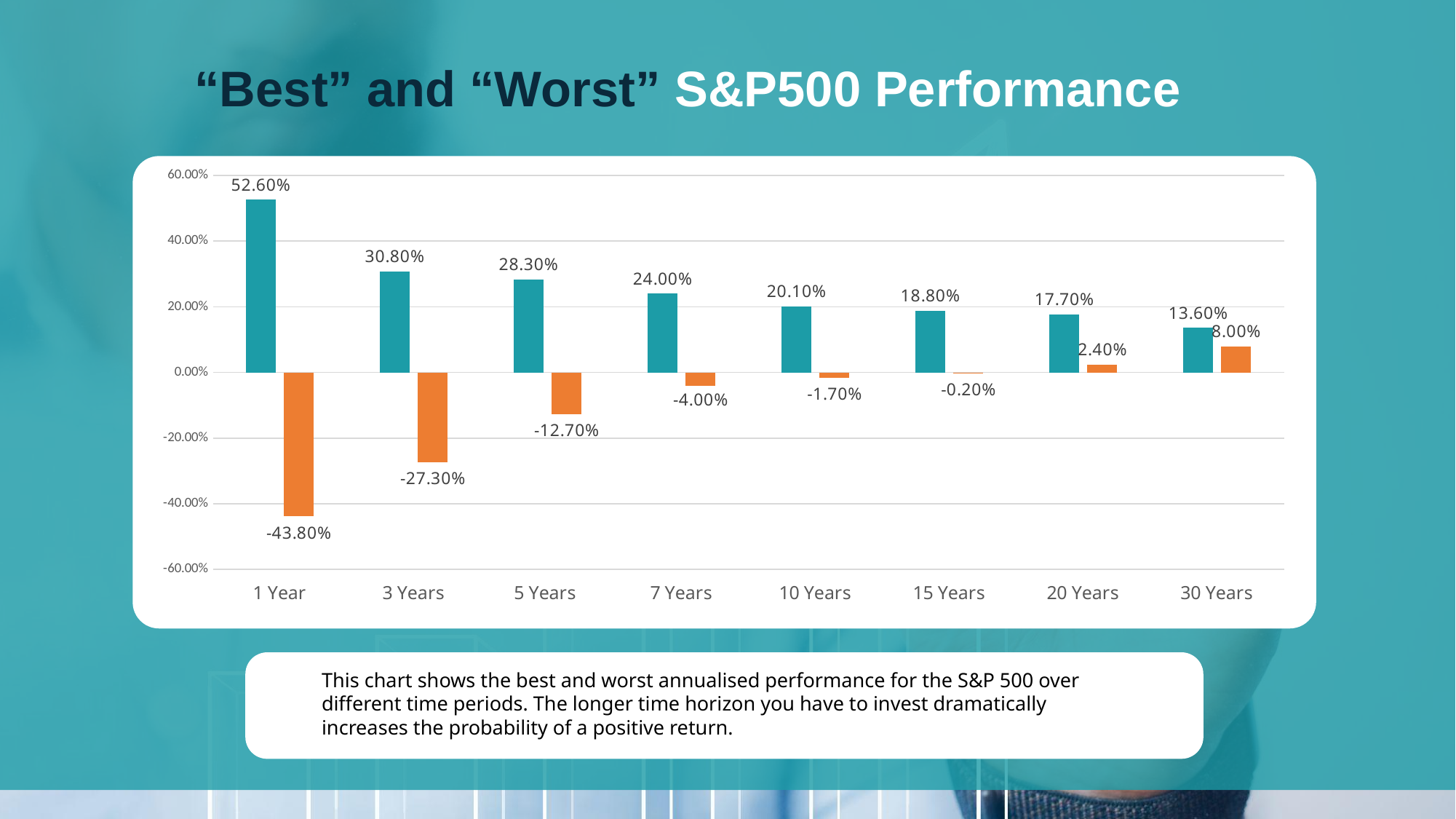
What is the title of the slide containing the chart? "Best" and "Worst" S&P500 Performance Which is larger, the teal (best) value for 7 Years or the teal (best) value for 15 Years? 7 Years What is the value of the orange (worst) bar for 3 Years? -27.30% Do the teal (best) values rise or fall as the time period increases from 1 Year to 30 Years? Fall How many time periods are shown on the x axis? 8 What kind of chart is shown on the slide? Bar chart Which time period has the lowest orange (worst) bar? 1 Year What is the value of the teal (best) bar for 10 Years? 20.10% What is the value of the teal (best) bar for 1 Year? 52.60% What is the difference between the teal (best) and orange (worst) values for 5 Years? 41.00% Which time period has the highest teal (best) bar? 1 Year What is the value of the orange (worst) bar for 30 Years? 8.00%